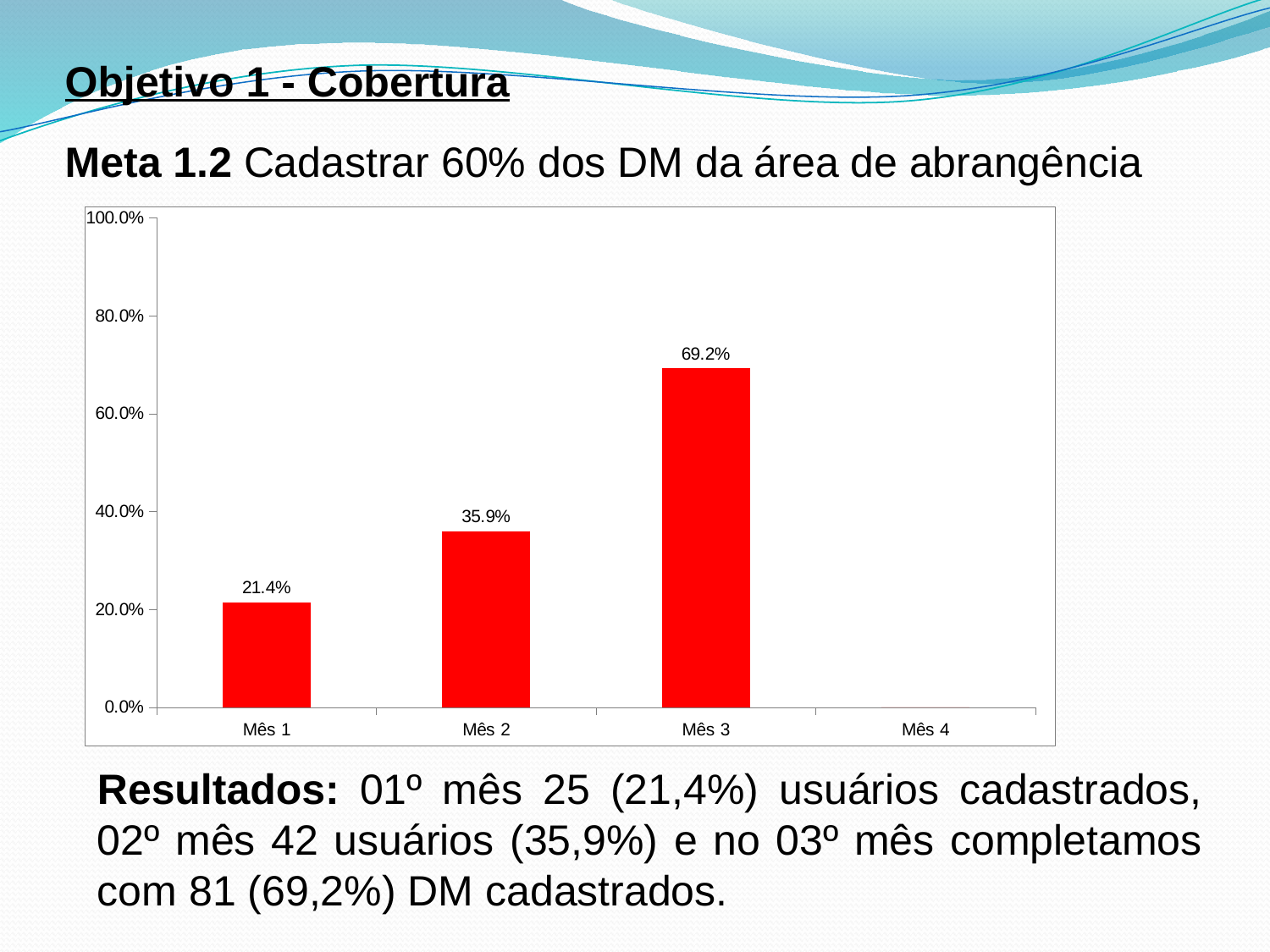
What is the value shown for Mês 3? 69.2% What kind of chart is shown on the slide? bar chart Among the months with a plotted bar, which has the lowest value? Mês 1 What is the difference between the values for Mês 2 and Mês 1? 14.5% Is the value for Mês 3 greater or less than 60.0%? greater Which month has the highest value in the chart? Mês 3 What is the value shown for Mês 1? 21.4% How many categories are labelled on the x axis of the chart? 4 Do the values rise or fall from Mês 1 to Mês 3? rise What is the difference between the values for Mês 3 and Mês 1? 47.8% Which is larger, the value for Mês 2 or the value for Mês 3? Mês 3 What is the value shown for Mês 2? 35.9%